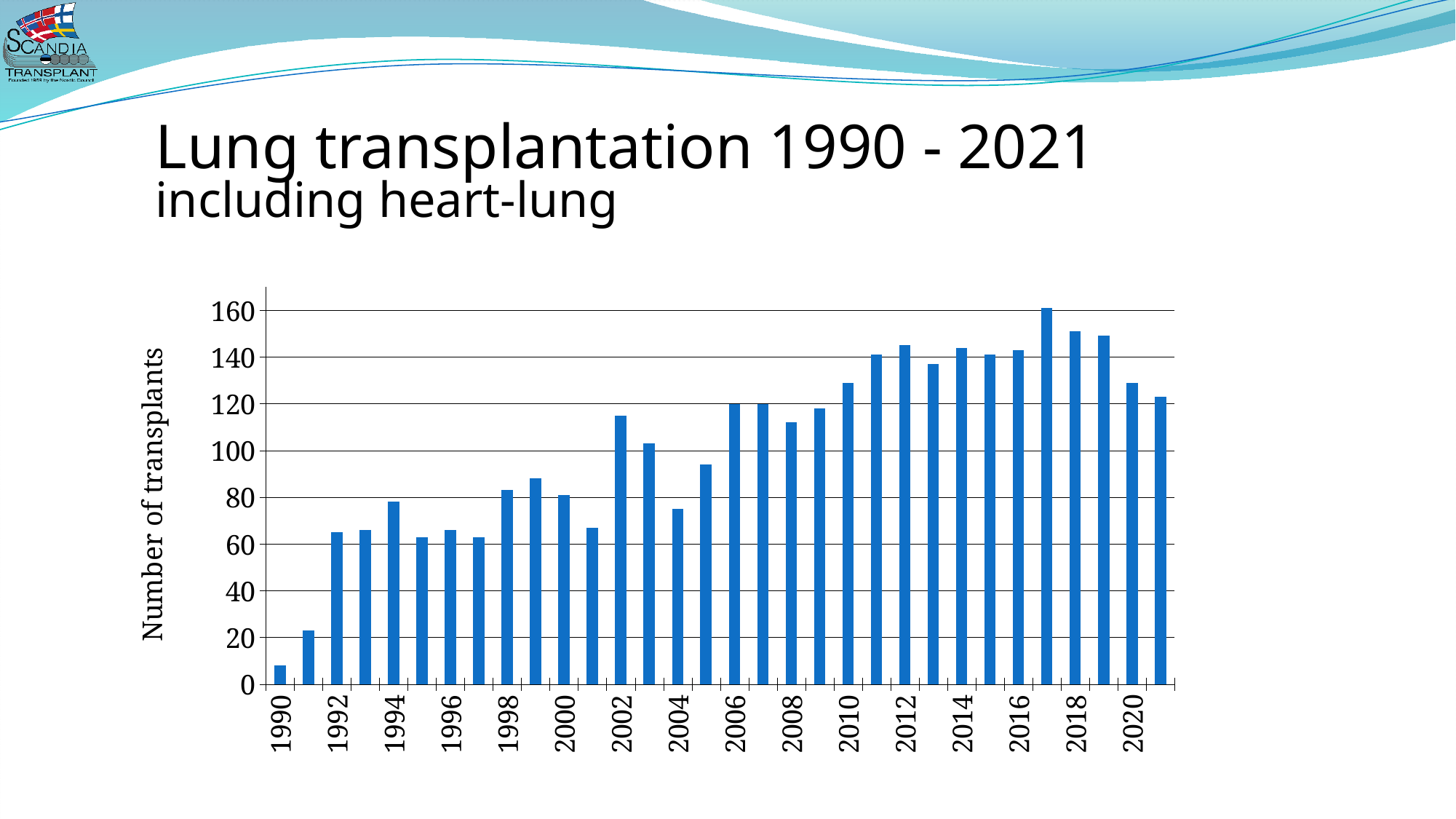
What is the label on the vertical axis? Number of transplants Which year has the highest number of transplants? 2017 Overall, do the values rise or fall from 1990 to 2021? rise Is the value for 1990 greater or less than 20? less Which year has more transplants, 2017 or 2018? 2017 Which year has more transplants, 2002 or 2003? 2002 What kind of chart is shown on the slide? bar chart Which year has the lowest number of transplants? 1990 Is the value for 2018 greater or less than 140? greater Is the value for 2002 greater or less than 100? greater How many years (bars) are plotted in the chart? 32